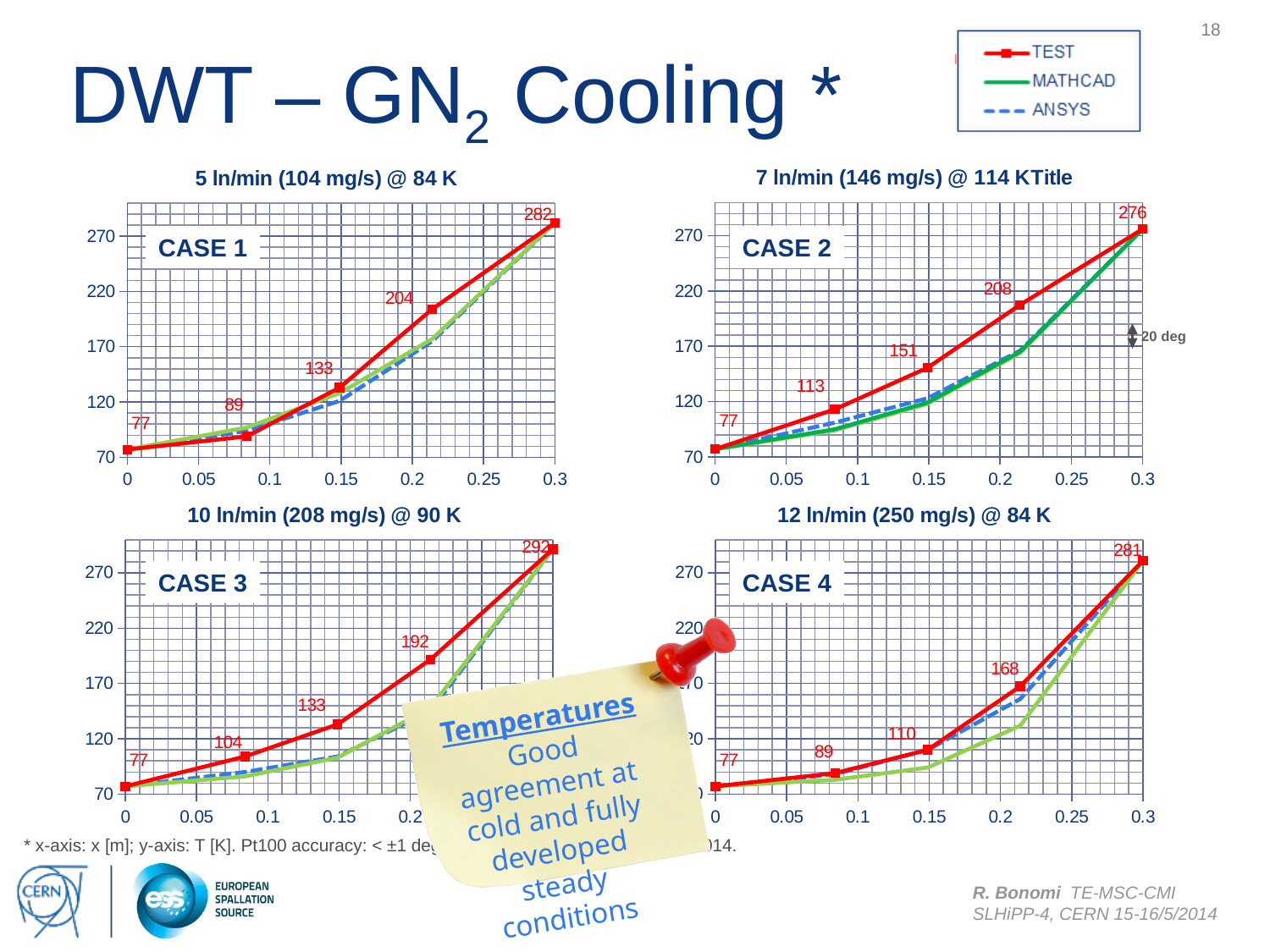
In the CASE 2 chart (7 ln/min (146 mg/s) @ 114 K), what is the TEST value labelled at the last point, x = 0.3? 276 In the CASE 2 chart, what is the lowest TEST data label? 77 What type of chart is used for CASE 2? Line chart In the CASE 1 chart, what is the difference between the last TEST label (282) and the first TEST label (77)? 205 In the CASE 1 chart (5 ln/min (104 mg/s) @ 84 K), what is the TEST value labelled at the last point, x = 0.3? 282 How many series does the legend at the top right of the slide list? 3 Which chart has the higher final TEST value at x = 0.3: CASE 3 or CASE 4? CASE 3 In the CASE 4 chart, is the TEST value at x = 0.3 greater or less than 270? greater In the CASE 3 chart (10 ln/min (208 mg/s) @ 90 K), what is the highest TEST data label? 292 How many TEST data labels are shown on the CASE 1 chart? 5 In the CASE 3 chart, do the TEST values rise or fall as x increases from 0 to 0.3? Rise In the CASE 4 chart (12 ln/min (250 mg/s) @ 84 K), what is the fourth TEST data label along the curve? 168